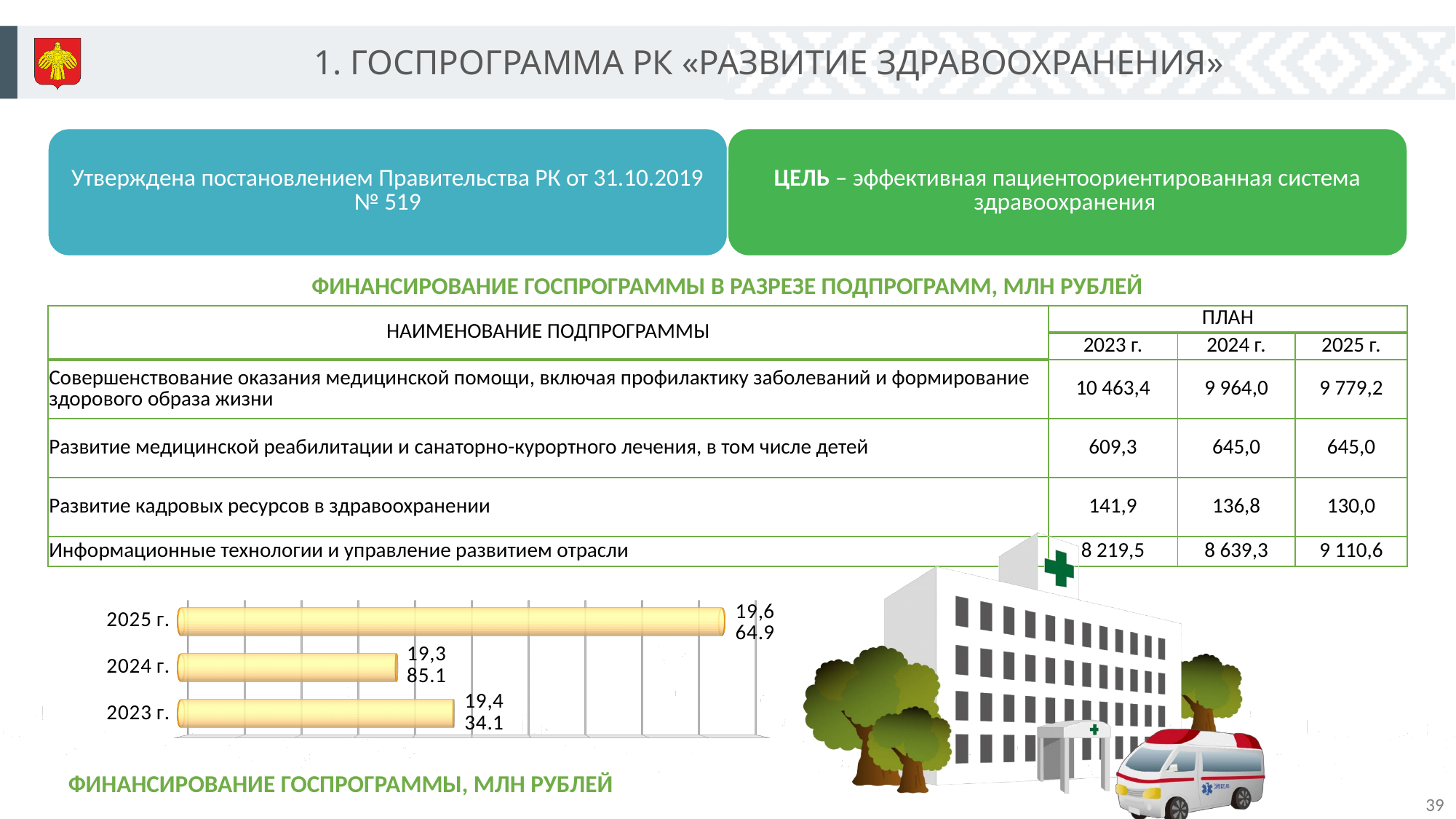
In the bar chart at the bottom left, which is larger: the value for 2025 г. or the value for 2024 г.? 2025 г. Which year has the shortest bar in the bar chart at the bottom left? 2024 г. What is the title of the bar chart at the bottom left of the slide? ФИНАНСИРОВАНИЕ ГОСПРОГРАММЫ, МЛН РУБЛЕЙ What kind of chart is shown at the bottom left of the slide? bar chart In the bar chart at the bottom left, is the bar for 2025 г. longer or shorter than the bar for 2023 г.? longer How many categories (years) does the bar chart at the bottom left show? 3 In the bar chart at the bottom left, is the bar for 2024 г. longer or shorter than the bar for 2023 г.? shorter Are the bars in the bar chart at the bottom left oriented horizontally or vertically? horizontally In the bar chart at the bottom left, does the value fall or rise from 2024 г. to 2025 г.? rise Which year has the longest bar in the bar chart at the bottom left? 2025 г. In the bar chart at the bottom left, does the value fall or rise from 2023 г. to 2024 г.? fall